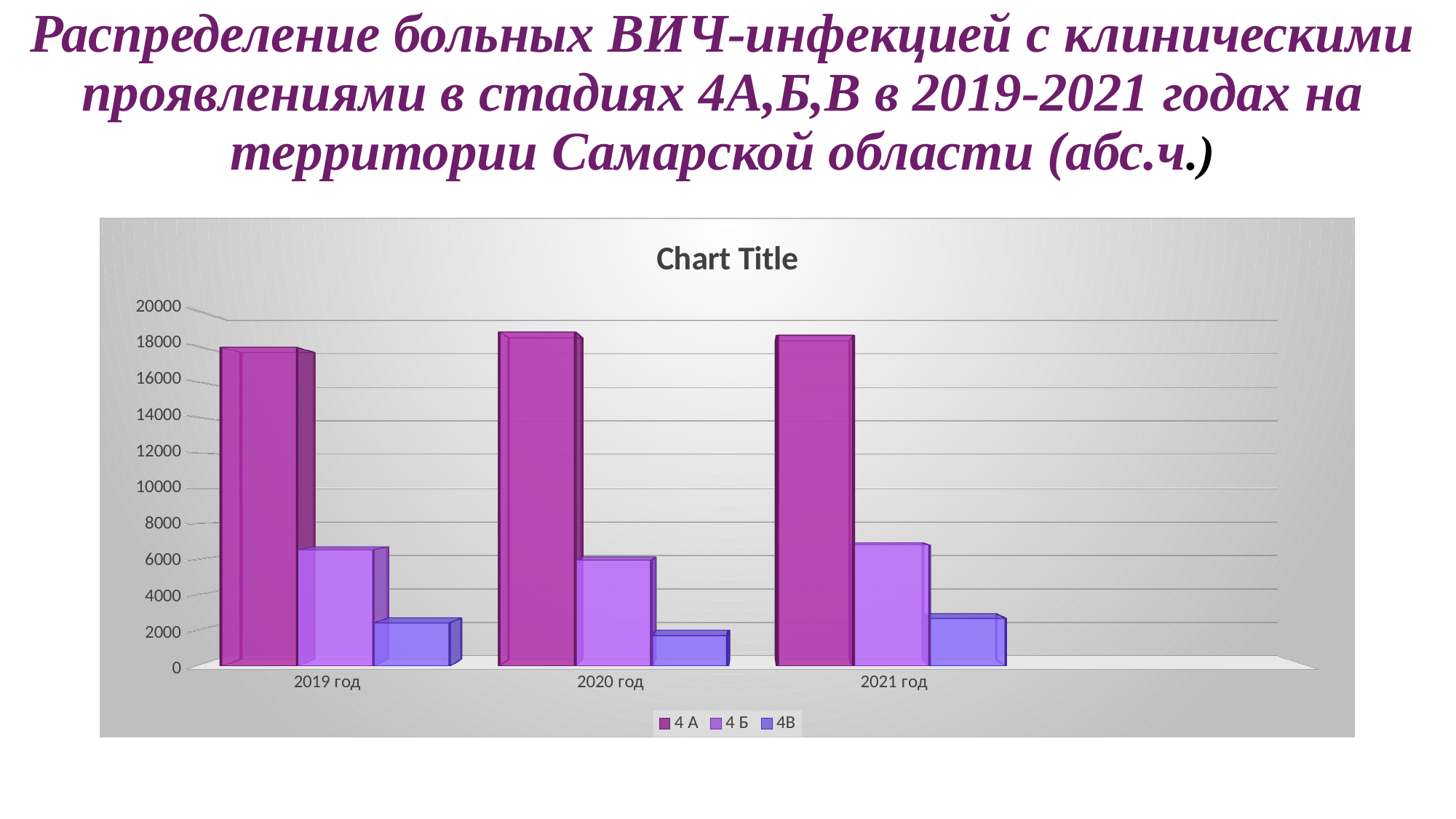
In which year is the value for 4 А the lowest? 2019 год How many year categories are shown on the x axis? 3 Is the value for 4В in 2021 год greater or less than 4000? less Is the value for 4 Б in 2020 год greater or less than 8000? less Is the value for 4 А in 2019 год greater or less than 16000? greater In 2019 год, which is larger: the value for 4 А or the value for 4 Б? 4 А How many series does the chart legend list? 3 Which series is shown in the darkest magenta colour in the legend? 4 А What kind of chart is shown on the slide? bar chart In which year is the value for 4В the lowest? 2020 год In 2021 год, which is larger: the value for 4 Б or the value for 4В? 4 Б